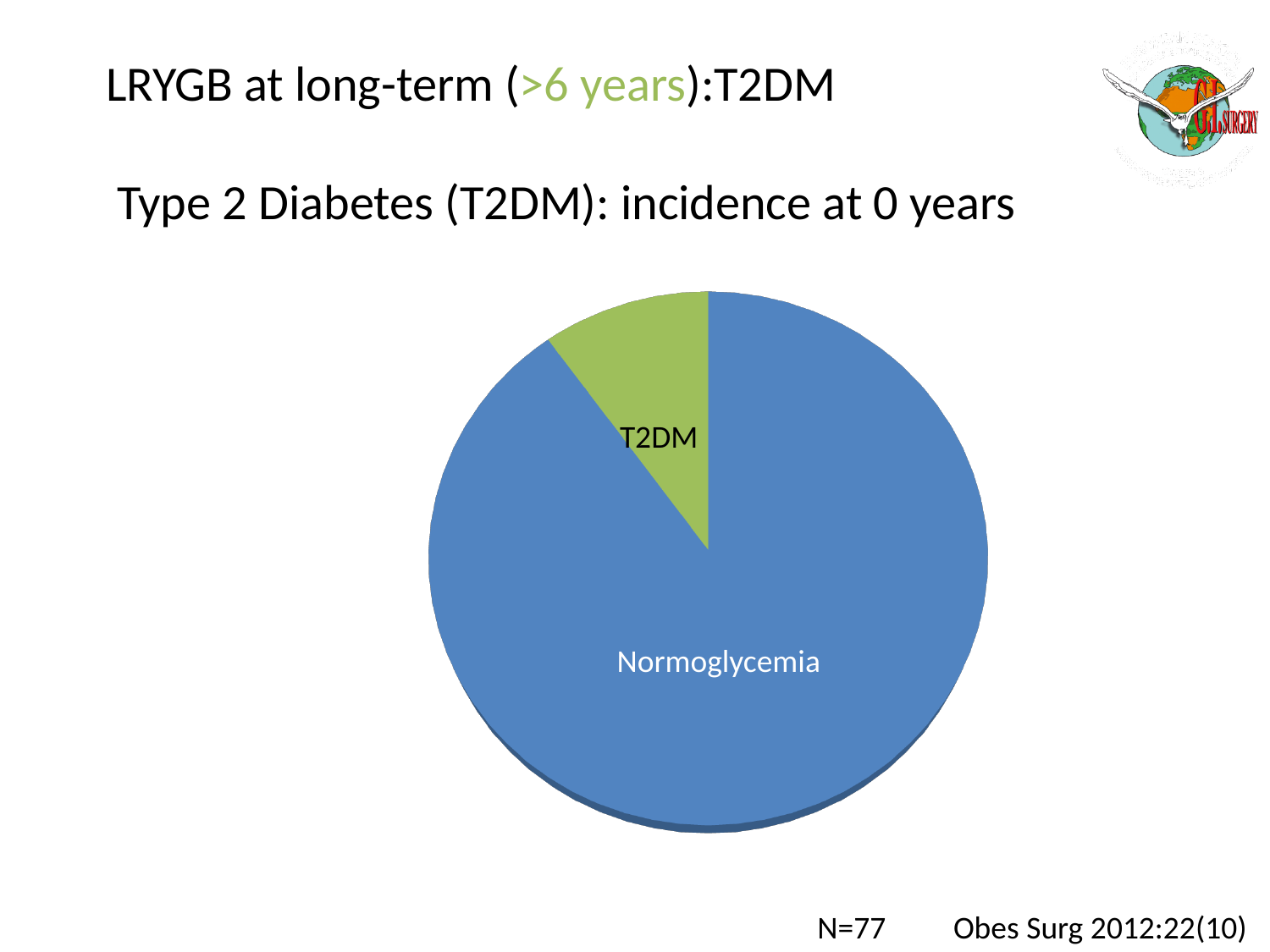
Does the T2DM slice take up more or less than half of the pie? less What colour is the T2DM slice? green What are the labels of the two slices in the pie chart? T2DM and Normoglycemia What kind of chart is shown on the slide? pie chart How many slices does the pie chart have? 2 Which slice is larger, T2DM or Normoglycemia? Normoglycemia What colour is the Normoglycemia slice? blue Which slice of the pie chart is the smallest? T2DM Which slice of the pie chart is the largest? Normoglycemia